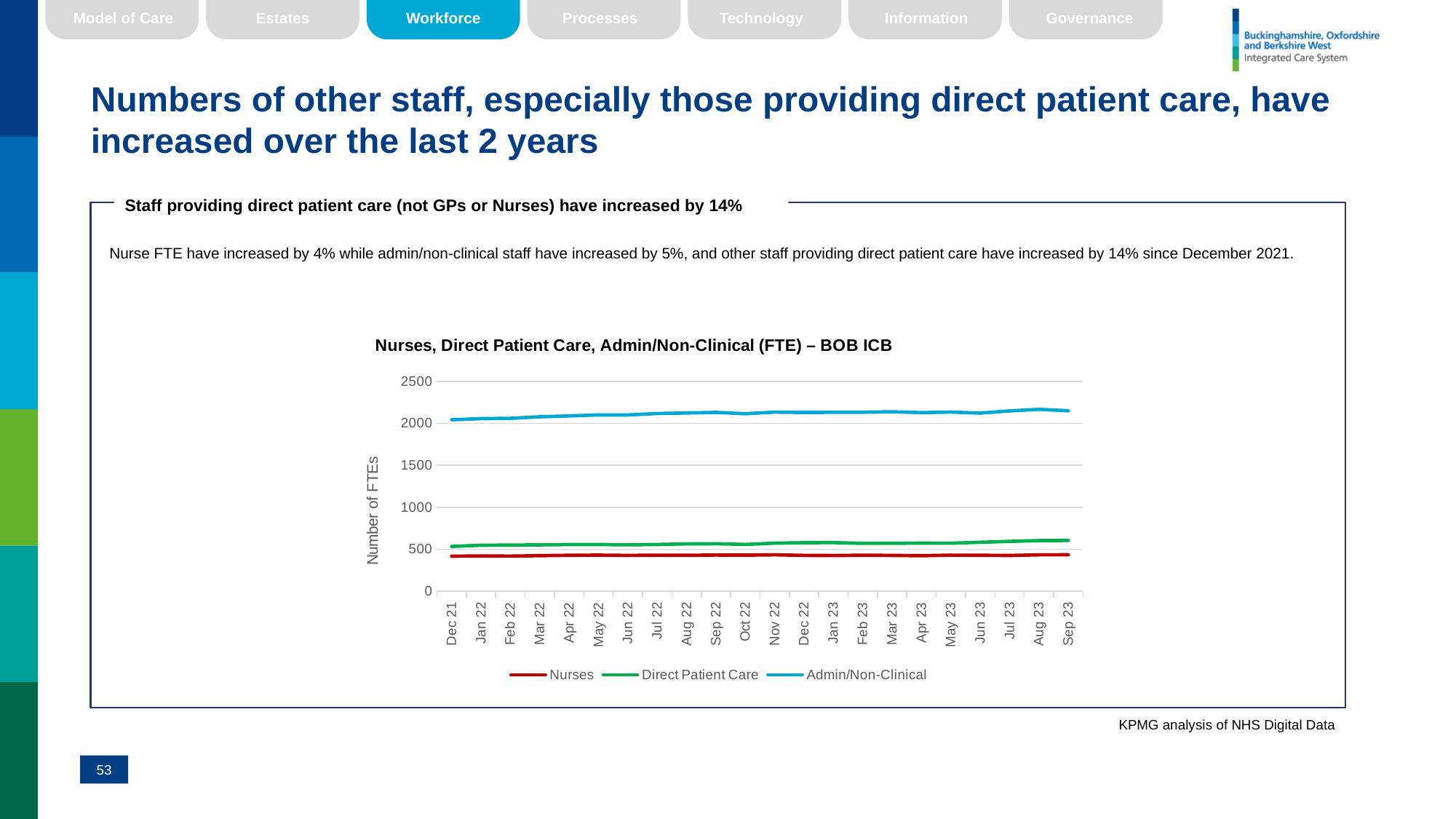
Which series has the highest values throughout the chart? Admin/Non-Clinical Is the value for Direct Patient Care in Sep 23 greater or less than 1000? less What is the title of the chart? Nurses, Direct Patient Care, Admin/Non-Clinical (FTE) – BOB ICB What is the label on the y axis of the chart? Number of FTEs Is the value for Nurses in Dec 21 greater or less than 500? less Which series has the lowest values throughout the chart? Nurses How many monthly data points are plotted along the x axis of the chart? 22 Which is larger in Sep 23, the value for Direct Patient Care or the value for Nurses? Direct Patient Care How many series does the chart legend list? 3 Is the value for Admin/Non-Clinical in Sep 23 greater or less than 2000? greater Does the Direct Patient Care line rise or fall from Dec 21 to Sep 23? Rise What kind of chart is shown on the slide? Line chart